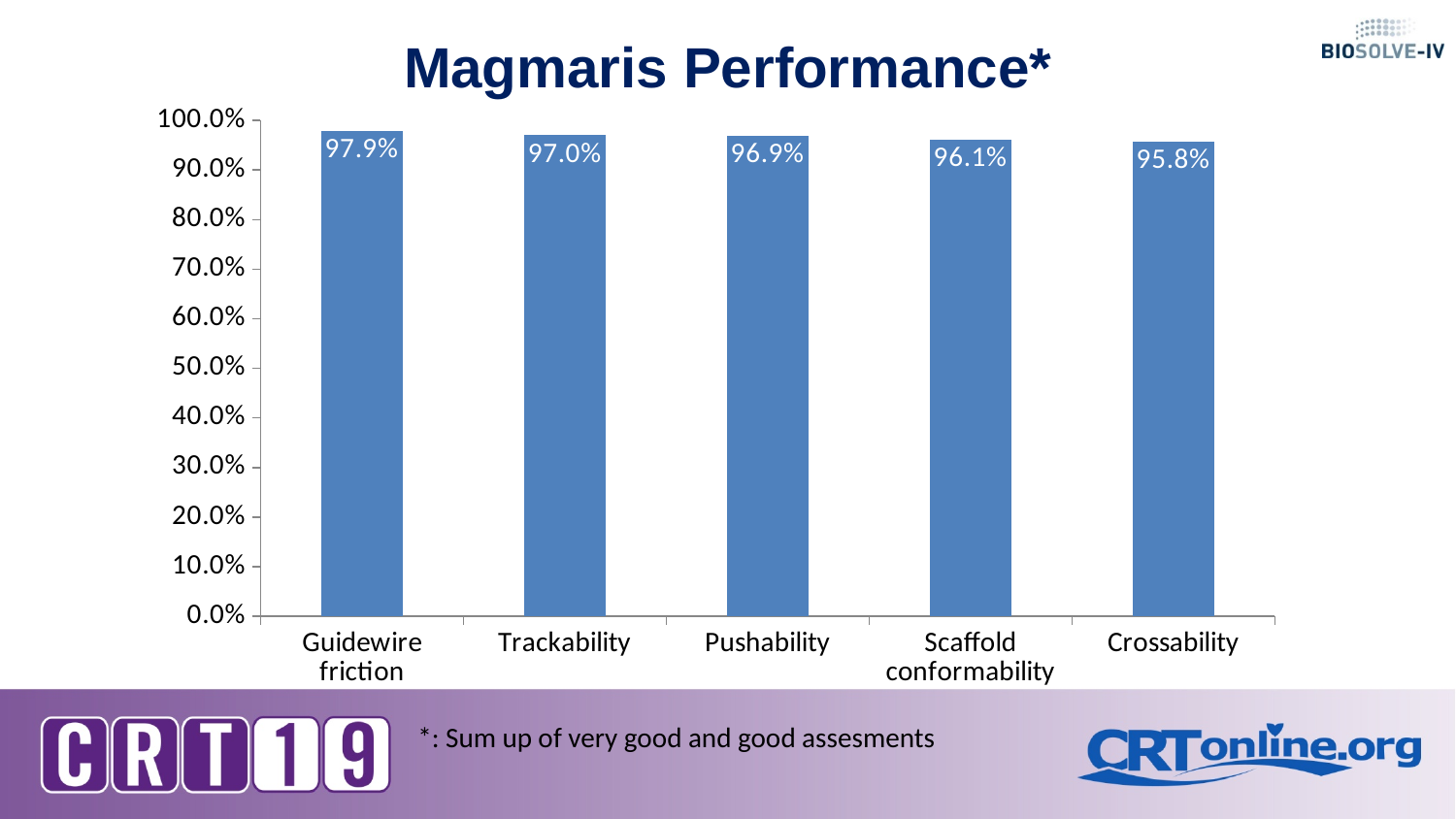
Which category has the highest value? Guidewire friction Which is larger, the value for Trackability or the value for Scaffold conformability? Trackability What is the value for Crossability? 95.8% What is the difference between the values for Guidewire friction and Crossability? 2.1% Which category has the lowest value? Crossability How many categories are shown on the x axis? 5 What is the value for Pushability? 96.9% What is the value for Trackability? 97.0% What is the value for Guidewire friction? 97.9% What is the value for Scaffold conformability? 96.1% What kind of chart is shown on the slide? Bar chart What is the title of the chart? Magmaris Performance*